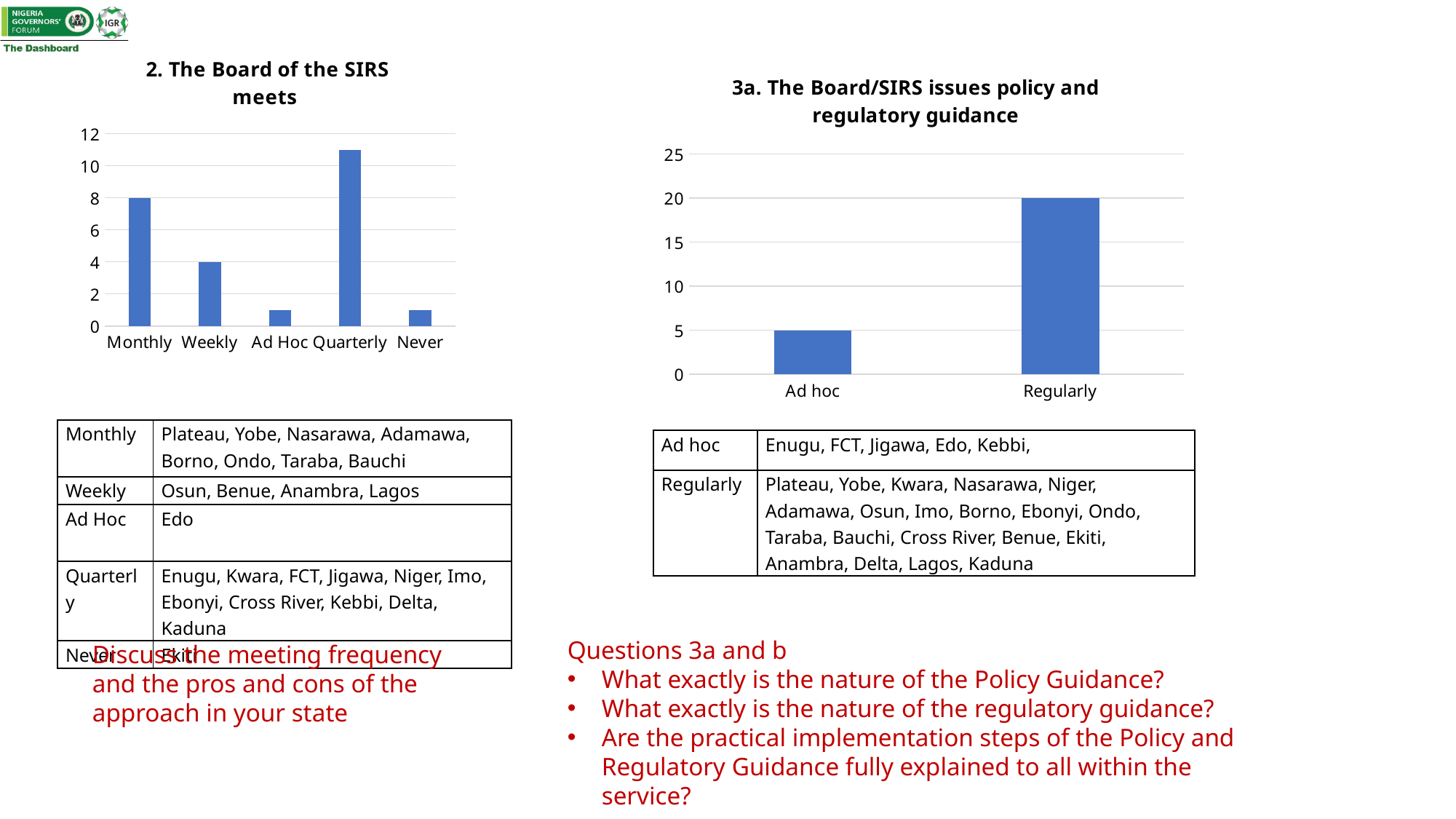
How many categories are shown in the chart '2. The Board of the SIRS meets'? 5 In the chart '3a. The Board/SIRS issues policy and regulatory guidance', what is the value for Ad hoc? 5 What kind of chart is '3a. The Board/SIRS issues policy and regulatory guidance'? Bar chart In the chart '3a. The Board/SIRS issues policy and regulatory guidance', what is the value for Regularly? 20 In the chart '2. The Board of the SIRS meets', what is the value for Weekly? 4 In the chart '2. The Board of the SIRS meets', what is the value for Monthly? 8 In the chart '2. The Board of the SIRS meets', which is larger, Monthly or Weekly? Monthly In the chart '2. The Board of the SIRS meets', is the value for Quarterly greater or less than 10? greater How many categories are shown in the chart '3a. The Board/SIRS issues policy and regulatory guidance'? 2 In the chart '3a. The Board/SIRS issues policy and regulatory guidance', what is the difference between Regularly and Ad hoc? 15 In the chart '2. The Board of the SIRS meets', which category has the highest value? Quarterly In the chart '2. The Board of the SIRS meets', is the value for Ad Hoc greater or less than 2? less